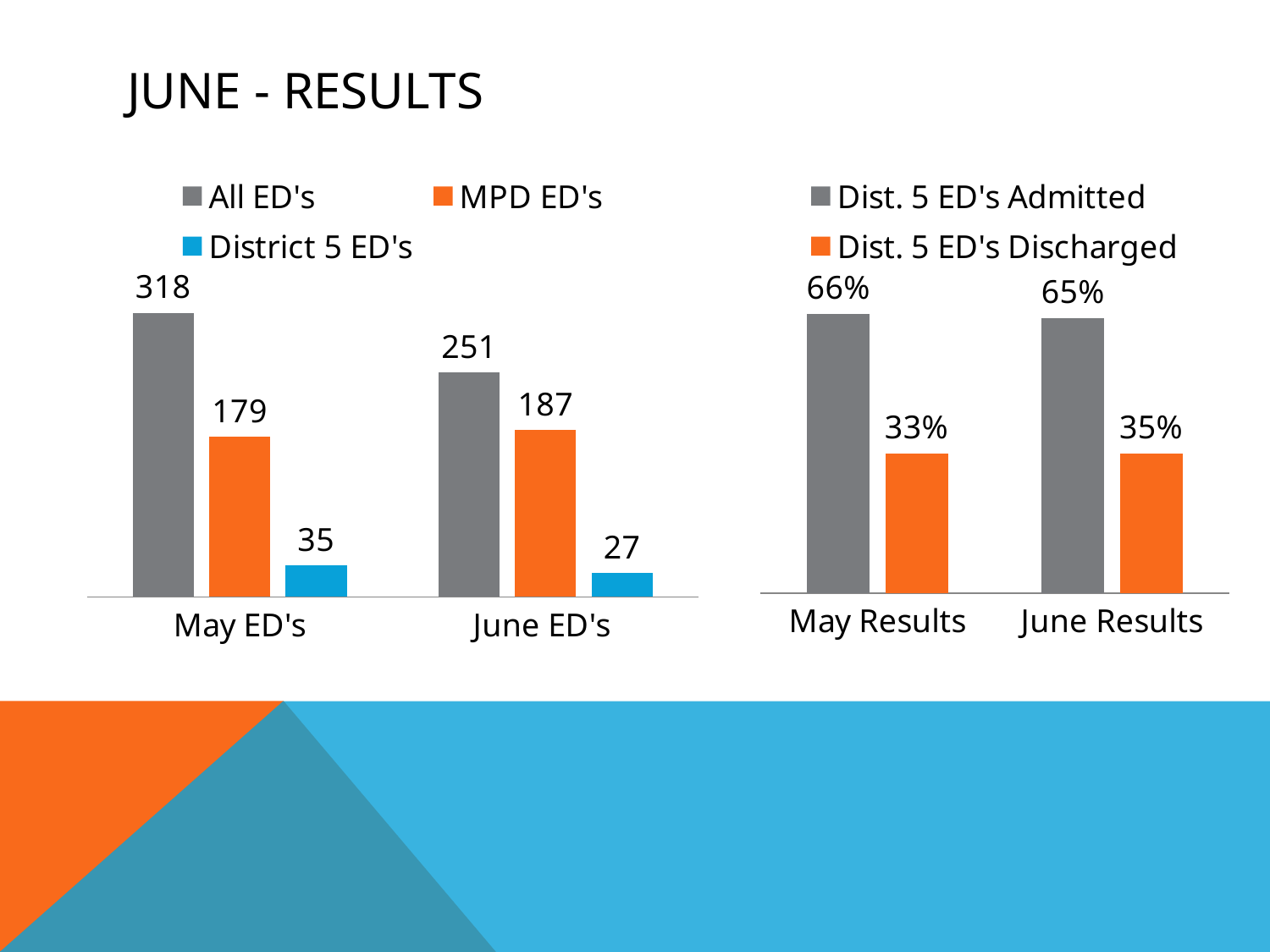
In the left chart, how many series does the legend list? 3 In the right chart, what is the difference between Dist. 5 ED's Admitted and Dist. 5 ED's Discharged in May Results? 33% In the right chart, how many categories are shown on the x axis? 2 In the left chart, what is the value for MPD ED's in June ED's? 187 In the left chart, which series has the lowest value in June ED's? District 5 ED's In the left chart, what is the difference between All ED's in May ED's and All ED's in June ED's? 67 In the left chart, which is larger: MPD ED's in May ED's or MPD ED's in June ED's? June ED's In the right chart, what is the value for Dist. 5 ED's Discharged in June Results? 35% In the right chart, what is the value for Dist. 5 ED's Admitted in May Results? 66% In the left chart, what is the value for All ED's in May ED's? 318 In the left chart, what is the value for District 5 ED's in May ED's? 35 What kind of chart is the right chart? Bar chart